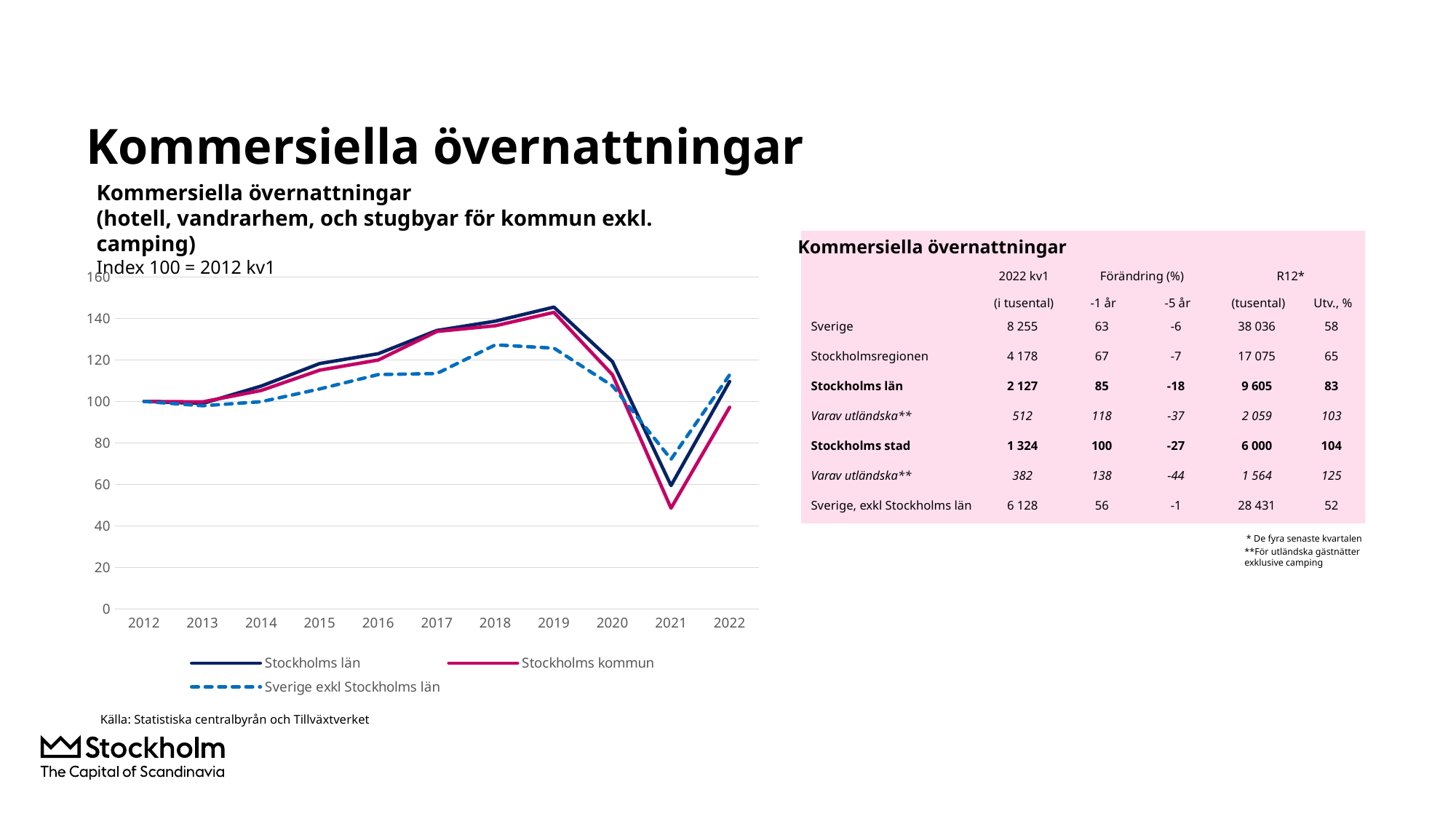
Is the value for Sverige exkl Stockholms län in 2019 greater or less than 140? less Do the values for Stockholms län rise or fall between 2019 and 2021? fall What is the index value for all series in 2012? 100 Is the value for Stockholms län in 2019 greater or less than 140? greater Is the value for Stockholms kommun in 2021 greater or less than 60? less How many series does the chart legend list? 3 How many years are shown on the x axis of the chart? 11 In 2021, which series has the larger value: Stockholms kommun or Sverige exkl Stockholms län? Sverige exkl Stockholms län In which year does the Stockholms län series reach its highest value? 2019 What kind of chart is shown on the slide? line chart In which year does the Stockholms kommun series reach its lowest value? 2021